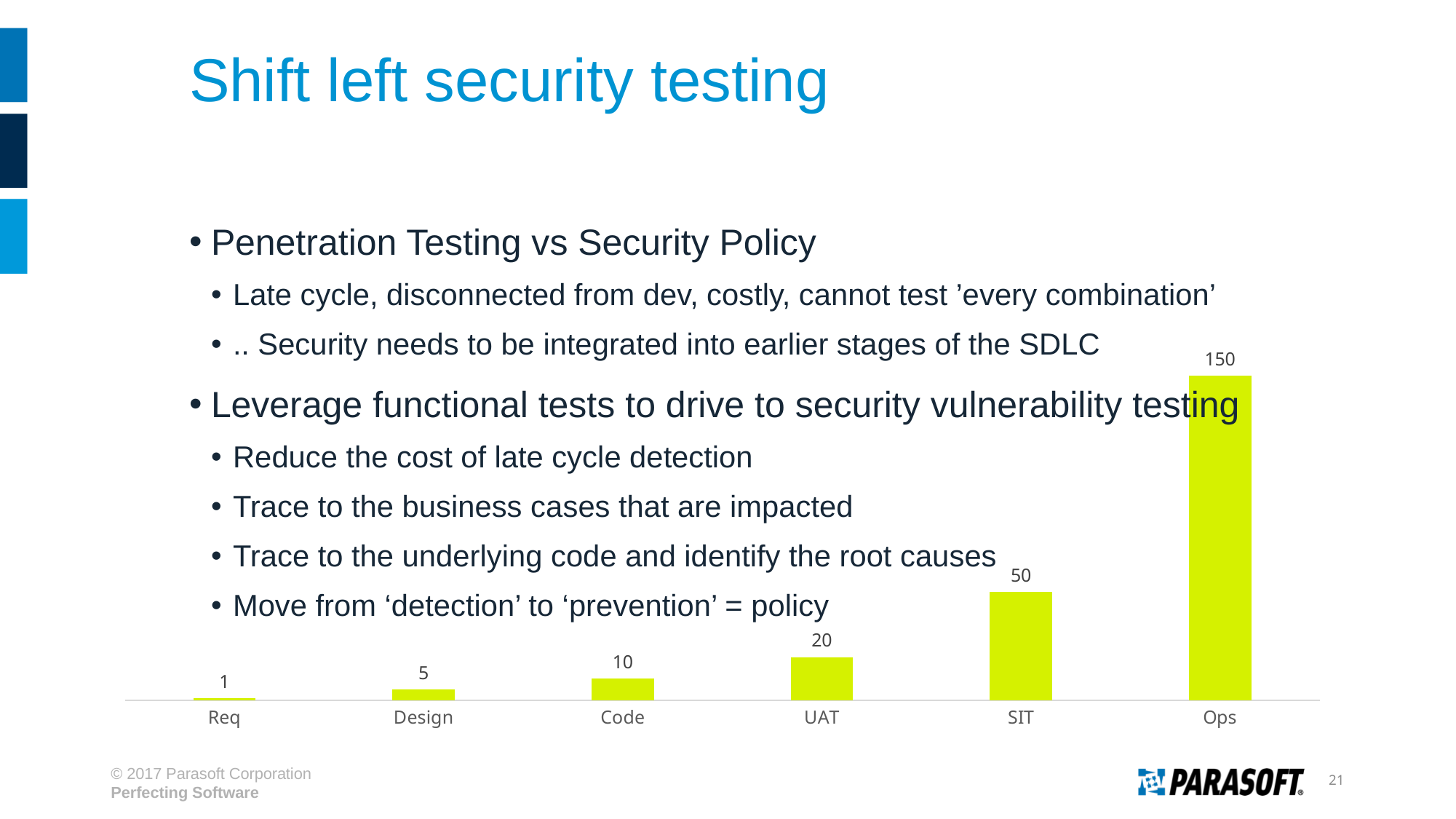
Which category has the lowest value? Req What is the difference between the values for Ops and SIT? 100 Which is larger, the value for UAT or the value for Code? UAT What kind of chart is shown on the slide? Bar chart What is the difference between the values for UAT and Design? 15 What is the value for Req? 1 How many categories are shown on the x axis? 6 What is the value for Code? 10 Which category has the highest value? Ops What is the value for Ops? 150 Do the values rise or fall from Req to Ops along the x axis? Rise What is the value for SIT? 50